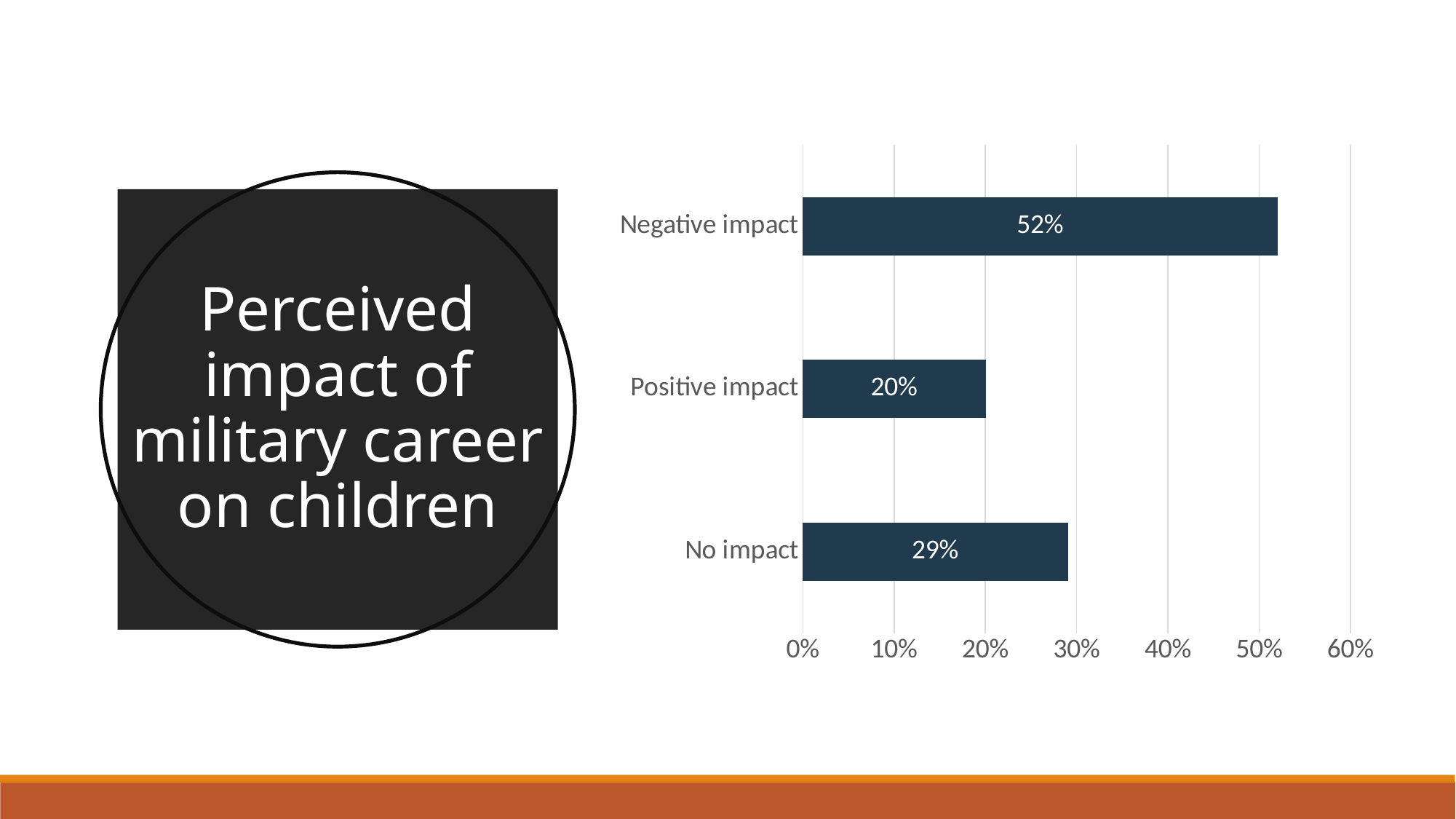
Is the value for Negative impact greater or less than 40%? greater What is the difference between the values for No impact and Positive impact? 9% What is the value for No impact? 29% Which category has the highest value? Negative impact What is the difference between the values for Negative impact and No impact? 23% Which category has the lowest value? Positive impact What is the value for Negative impact? 52% How many categories are shown in the chart? 3 What is the value for Positive impact? 20% Which is larger, the value for No impact or the value for Positive impact? No impact What kind of chart is shown on the slide? bar chart What is the title text shown next to the chart? Perceived impact of military career on children